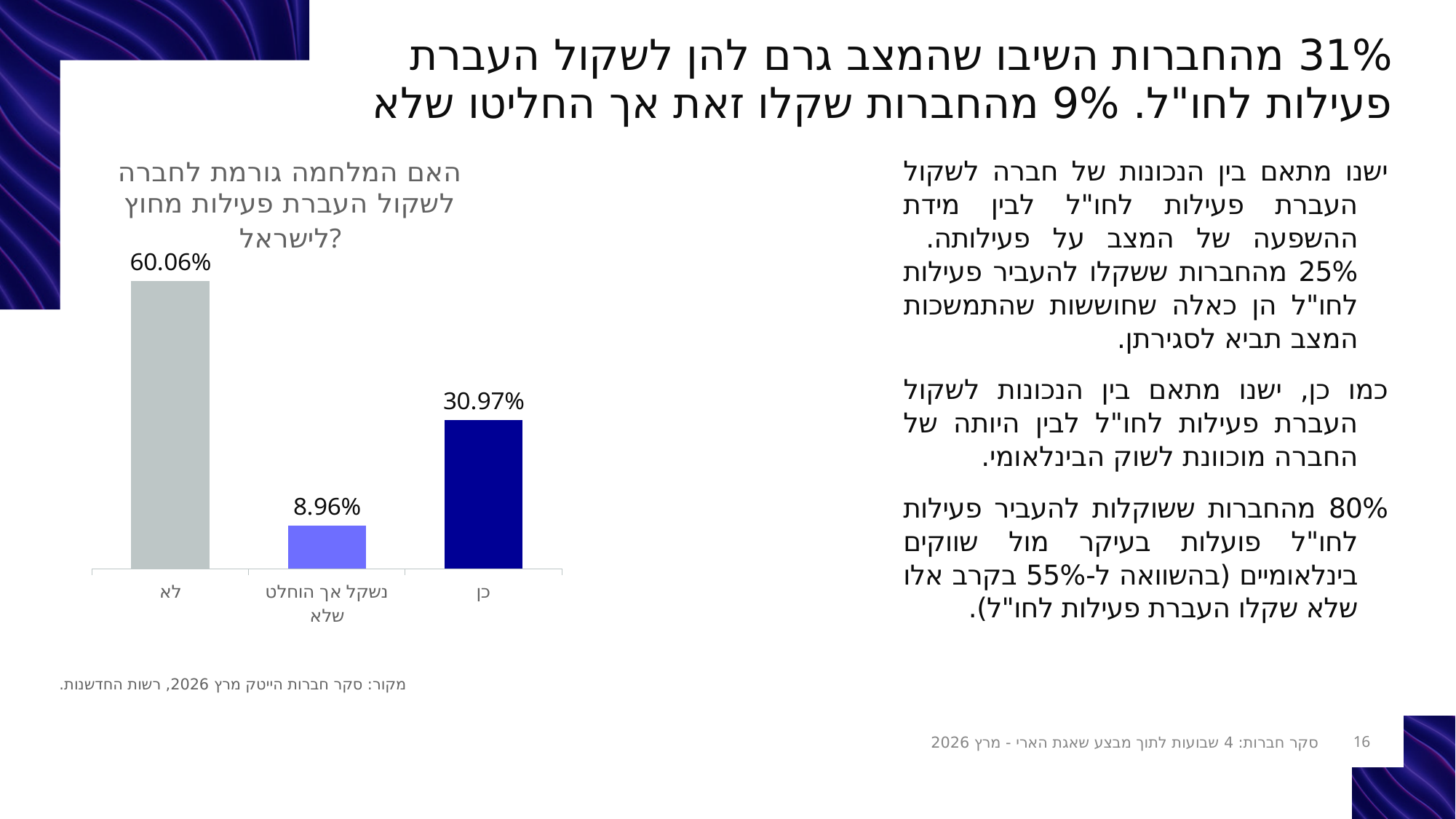
Which category has the highest value in the chart? לא What is the title of the chart? האם המלחמה גורמת לחברה לשקול העברת פעילות מחוץ לישראל? What is the difference between the values for "לא" and "כן"? 29.09% How many categories are shown in the chart? 3 What is the value for the category "כן" in the chart? 30.97% What colour is the bar for the category "כן"? Dark blue Which category has the lowest value in the chart? נשקל אך הוחלט שלא What is the value for the category "נשקל אך הוחלט שלא" in the chart? 8.96% What is the difference between the values for "כן" and "נשקל אך הוחלט שלא"? 22.01% Which is larger, the value for "כן" or the value for "נשקל אך הוחלט שלא"? כן What is the value for the category "לא" in the chart? 60.06% What kind of chart is shown on the slide? Bar chart